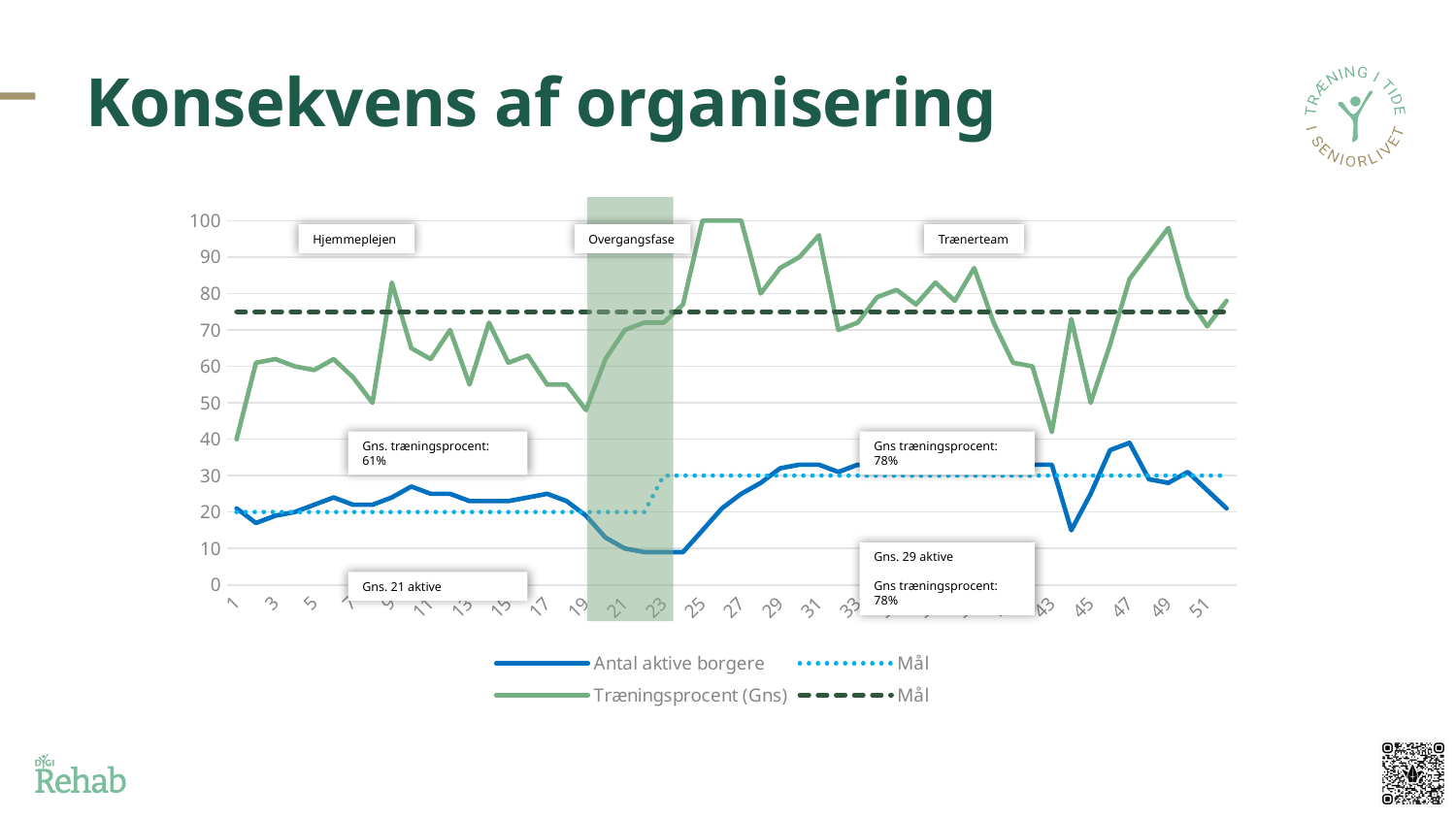
Which is larger: the Træningsprocent (Gns) value at x = 25 or at x = 43? x = 25 What is the average number of active citizens (Gns. aktive) shown for the Hjemmeplejen phase? 21 Does the Antal aktive borgere line rise or fall between x = 17 and x = 21? fall What is the average number of active citizens (Gns. aktive) shown for the Trænerteam phase? 29 What is the average training percentage (Gns. træningsprocent) shown for the Hjemmeplejen phase? 61% What is the average training percentage (Gns træningsprocent) shown for the Trænerteam phase? 78% Is the value of Antal aktive borgere at x = 21 greater or less than 20? less What are the three phases labelled on the chart? Hjemmeplejen, Overgangsfase, Trænerteam Is the value of Træningsprocent (Gns) at x = 43 greater or less than 50? less Is the value of Træningsprocent (Gns) at x = 25 greater or less than 90? greater How many series does the legend list? 4 What kind of chart is shown on the slide? line chart